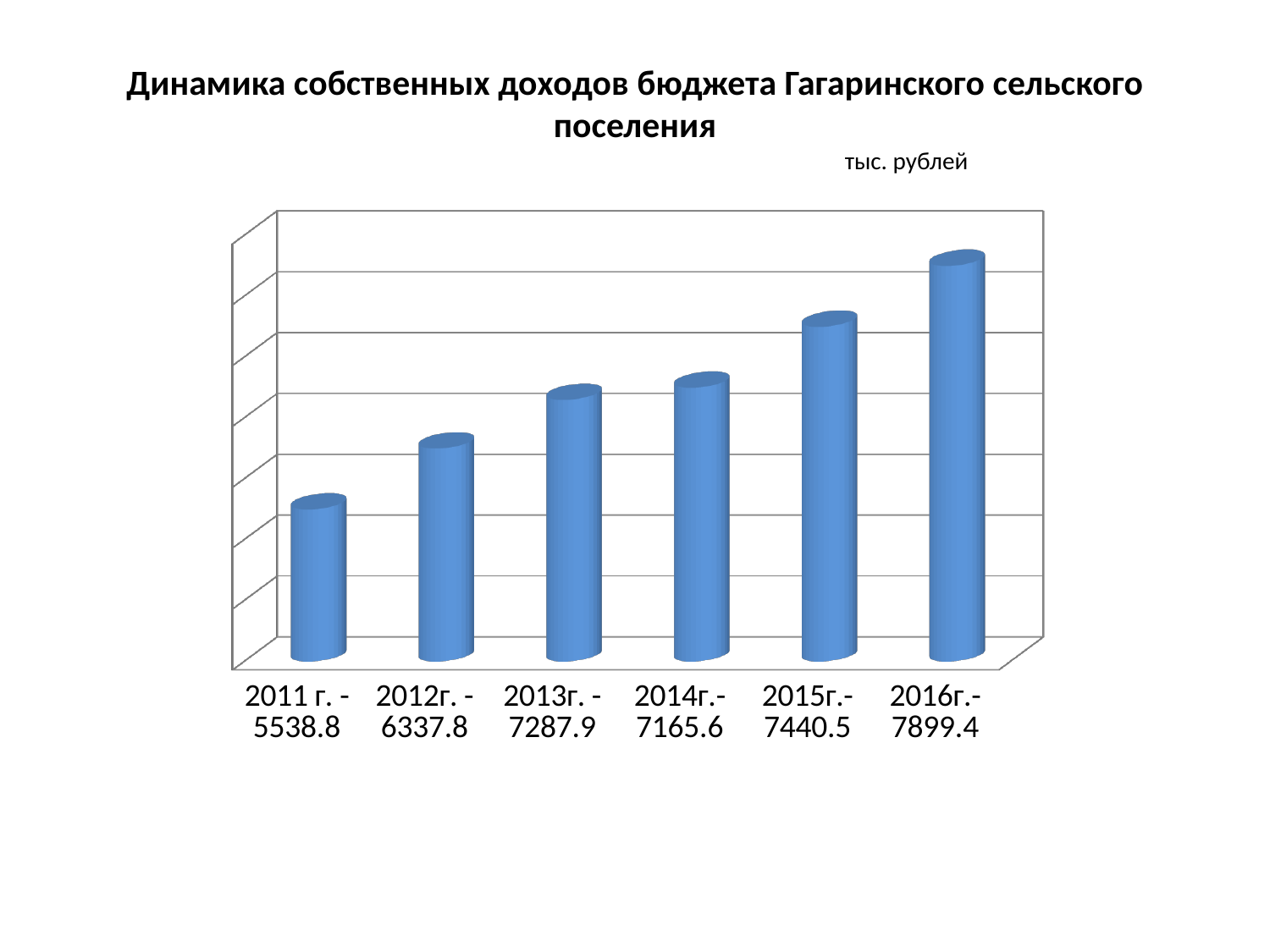
What is the value for 2016г.? 7899.4 How many years are shown on the chart? 6 Which year has the lowest value? 2011 г. Which is larger, the value for 2013г. or the value for 2014г.? 2013г. What is the value for 2014г.? 7165.6 What kind of chart is this? bar chart In what units are the values on the chart given? тыс. рублей What is the difference between the values for 2013г. and 2014г.? 122.3 Which year has the highest value? 2016г. Do the values generally rise or fall from 2011 to 2016? rise What is the value for 2011 г.? 5538.8 What is the difference between the values for 2016г. and 2011 г.? 2360.6